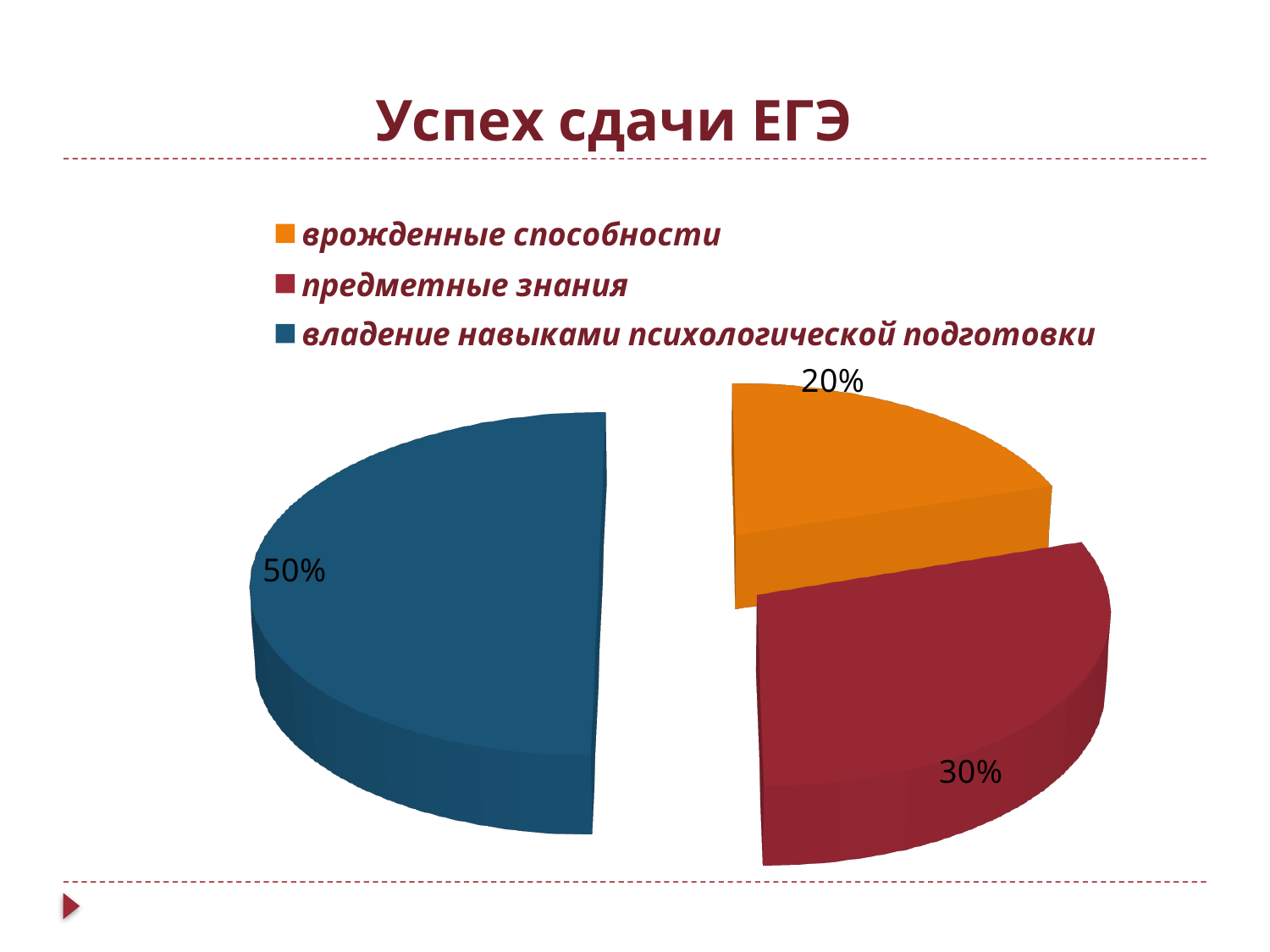
How many entries does the legend list? 3 Which category has the smallest slice of the pie? врожденные способности What share of the pie does 'врожденные способности' have? 20% What is the title of the slide? Успех сдачи ЕГЭ Which is larger: the slice for 'предметные знания' or the slice for 'врожденные способности'? предметные знания What is the difference in percentage points between 'владение навыками психологической подготовки' and 'предметные знания'? 20 What share of the pie does 'предметные знания' have? 30% What colour is the slice for 'предметные знания'? red What share of the pie does 'владение навыками психологической подготовки' have? 50% What kind of chart is shown on the slide? pie chart How many slices does the pie chart have? 3 Which category has the largest slice of the pie? владение навыками психологической подготовки